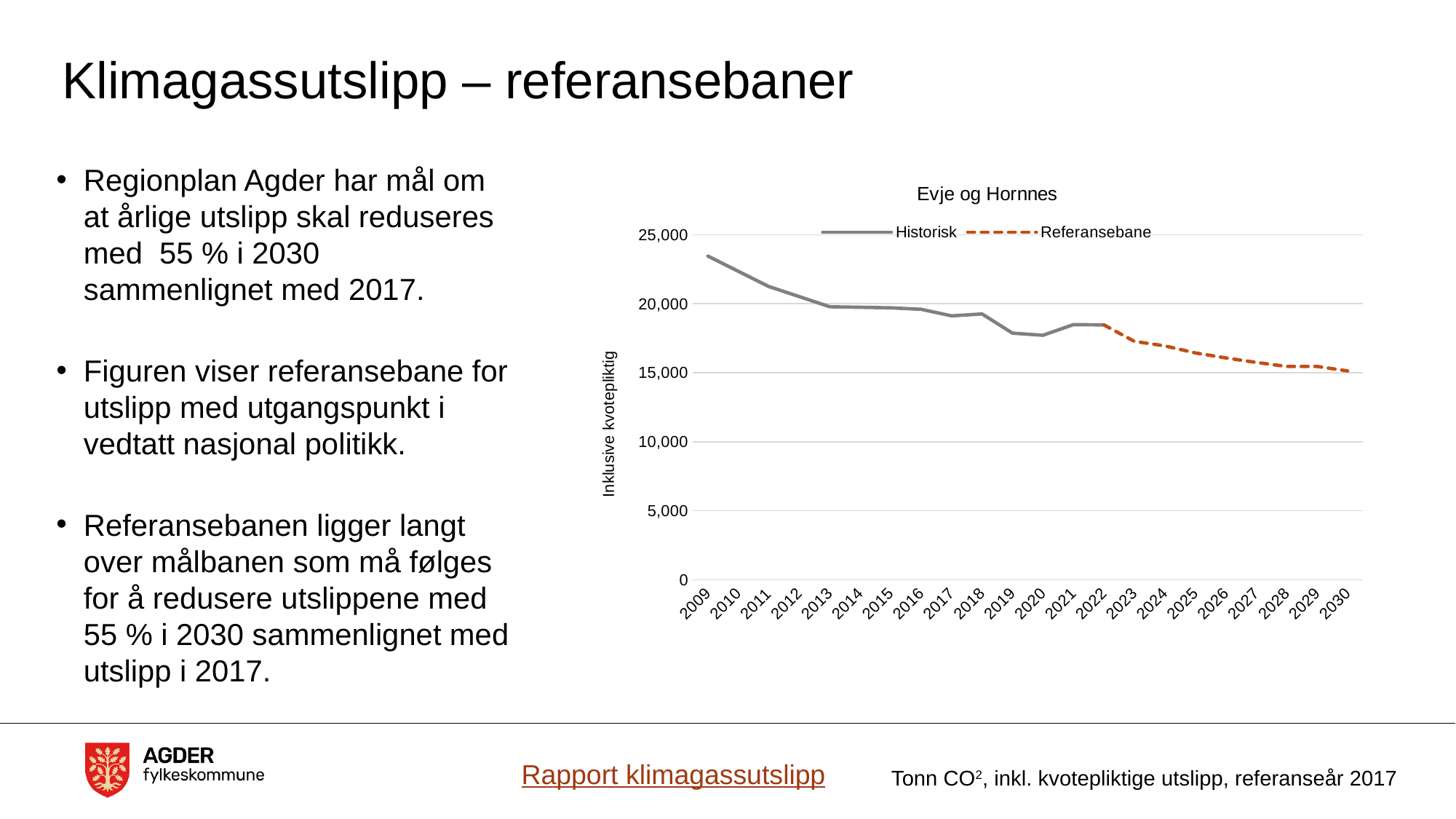
Is the value for 2025 greater or less than 15,000? greater What is the title of the chart? Evje og Hornnes What kind of chart is shown on the slide? Line chart Which year has the highest value in the chart? 2009 Do the values in the chart generally rise or fall from 2009 to 2030? Fall How many years are shown on the x axis of the chart? 22 Is the value for 2019 greater or less than 20,000? less Which is larger, the value for 2009 or the value for 2019? 2009 Which year has the lowest value in the chart? 2030 How many series does the chart legend list? 2 Which series is drawn with a dashed line? Referansebane Is the value for 2009 greater or less than 20,000? greater